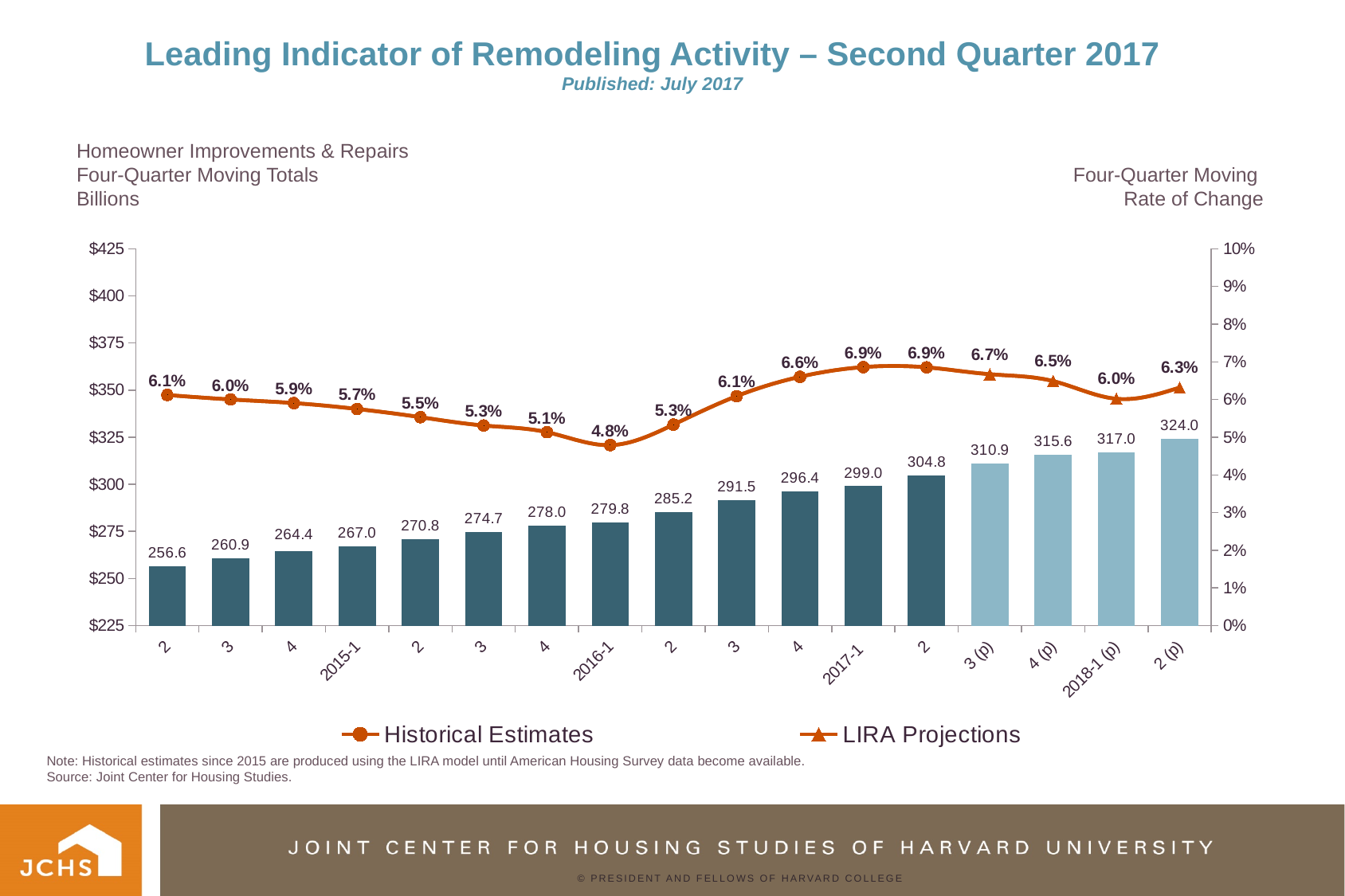
Do the four-quarter moving totals rise or fall from left to right along the x axis? Rise What is the projected four-quarter moving total for 2018-1 (p)? 317.0 What is the four-quarter moving total for 2017-1? 299.0 What kind of chart is shown on the slide? Combination bar and line chart What is the four-quarter moving rate of change for 2016-1? 4.8% How many series does the legend list? 2 What is the difference between the four-quarter moving totals for 2 (p) and 2018-1 (p)? 7.0 How many bars are plotted in the chart? 17 Which quarter has the highest four-quarter moving total? 2 (p) What are the two legend entries for the line series? Historical Estimates and LIRA Projections Which quarter has the lowest four-quarter moving rate of change? 2016-1 Which is larger, the four-quarter moving total for quarter 2 of 2016 or quarter 3 of 2016? Quarter 3 of 2016